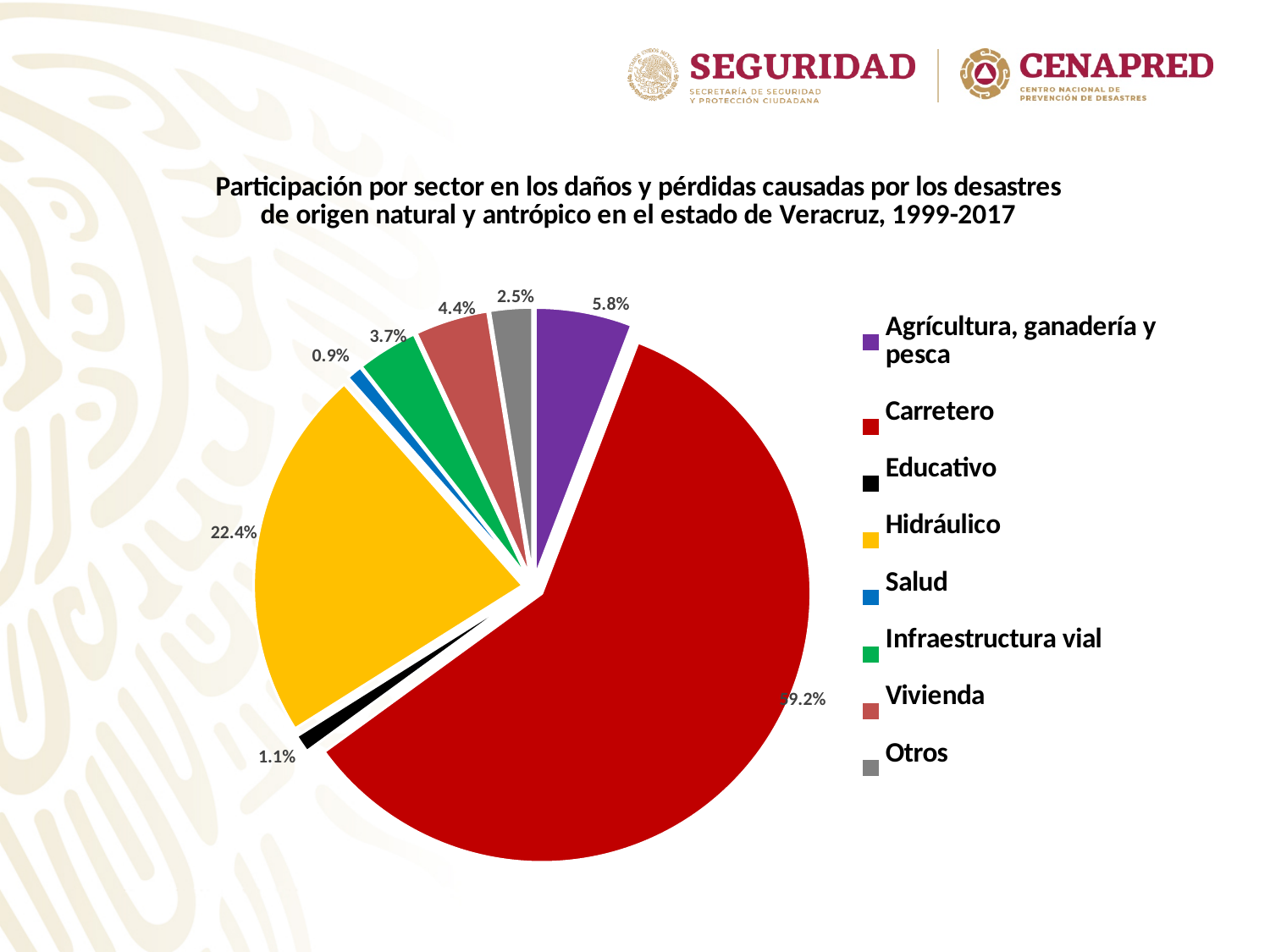
How many sectors are listed in the legend? 8 What share of the pie does Hidráulico represent? 22.4% Which has a larger share, Infraestructura vial or Vivienda? Vivienda What type of chart is shown on the slide? pie chart What colour is the Hidráulico slice? yellow What is the value shown for Vivienda? 4.4% Which sector has the largest share of the pie? Carretero Which sector has the smallest share of the pie? Salud What is the value shown for Salud? 0.9% What is the value shown for Agrícultura, ganadería y pesca? 5.8% What is the difference between the shares of Hidráulico and Agrícultura, ganadería y pesca? 16.6% What is the value shown for Otros? 2.5%